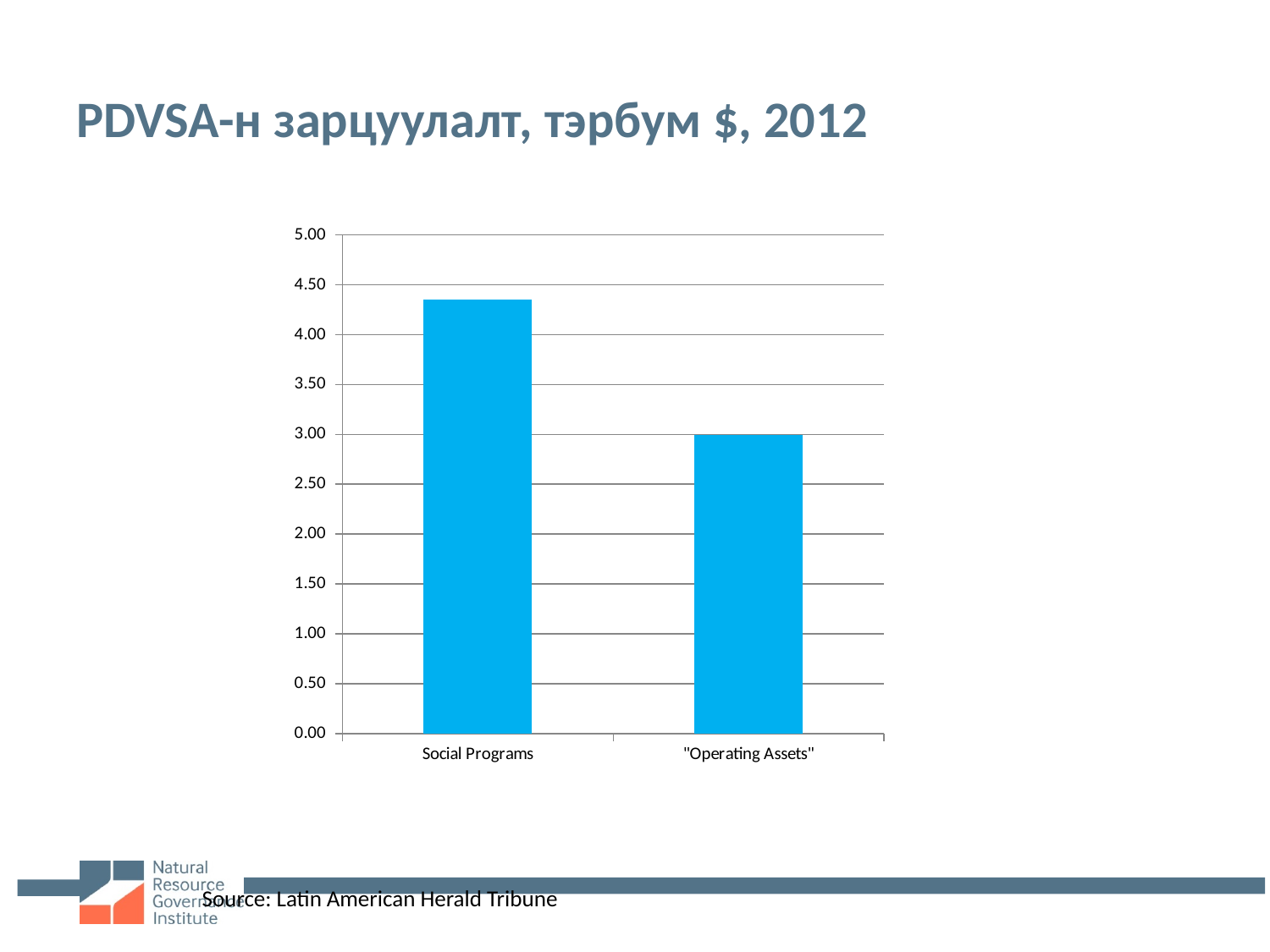
How many categories are plotted in the chart? 2 What is the highest value shown on the vertical axis of the chart? 5.00 What is the title of the slide containing the chart? PDVSA-н зарцуулалт, тэрбум $, 2012 Which is larger, the value for Social Programs or the value for "Operating Assets"? Social Programs What kind of chart is shown on the slide? bar chart Is the value for Social Programs greater or less than 4.50? less Which category has the lowest value? "Operating Assets" Is the value for Social Programs greater or less than 4.00? greater Is the value for "Operating Assets" greater or less than 2.50? greater Which category has the highest value? Social Programs